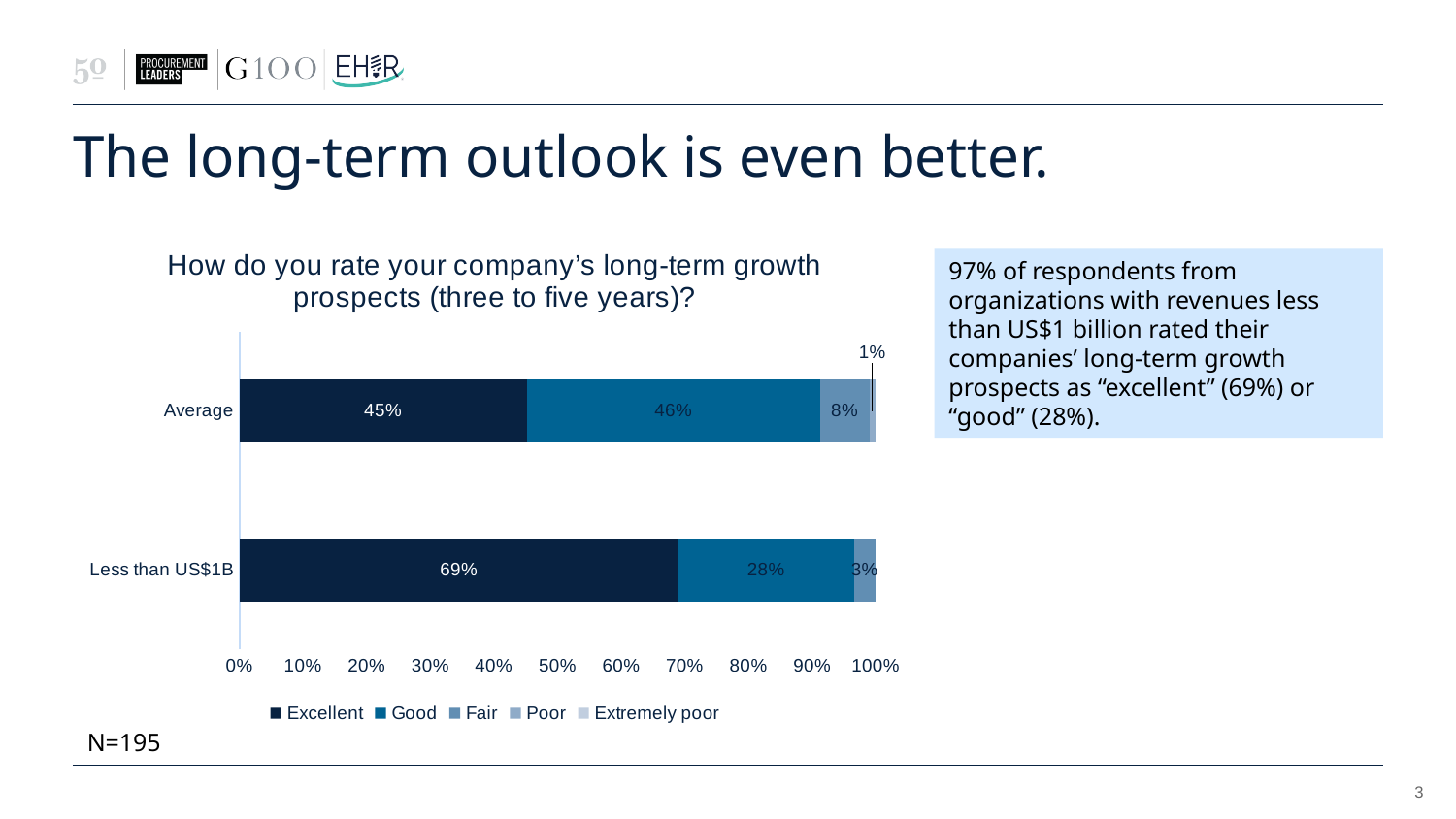
What is the Good value for the Less than US$1B bar? 28% What is the title of the chart? How do you rate your company's long-term growth prospects (three to five years)? What percentage of respondents from organizations with revenues Less than US$1B rated their prospects as Excellent? 69% What is the Fair value for the Average bar? 8% What is the Good value for the Average bar? 46% How many series does the legend list? 5 What kind of chart is shown on the slide? Stacked bar chart How many categories are shown on the chart? 2 What is the difference between the Excellent share for Less than US$1B and the Excellent share for Average? 24% What percentage of respondents in the Average category rated their long-term growth prospects as Excellent? 45% Which category has the higher Excellent share, Average or Less than US$1B? Less than US$1B What is the difference between the Good share for Average and the Good share for Less than US$1B? 18%